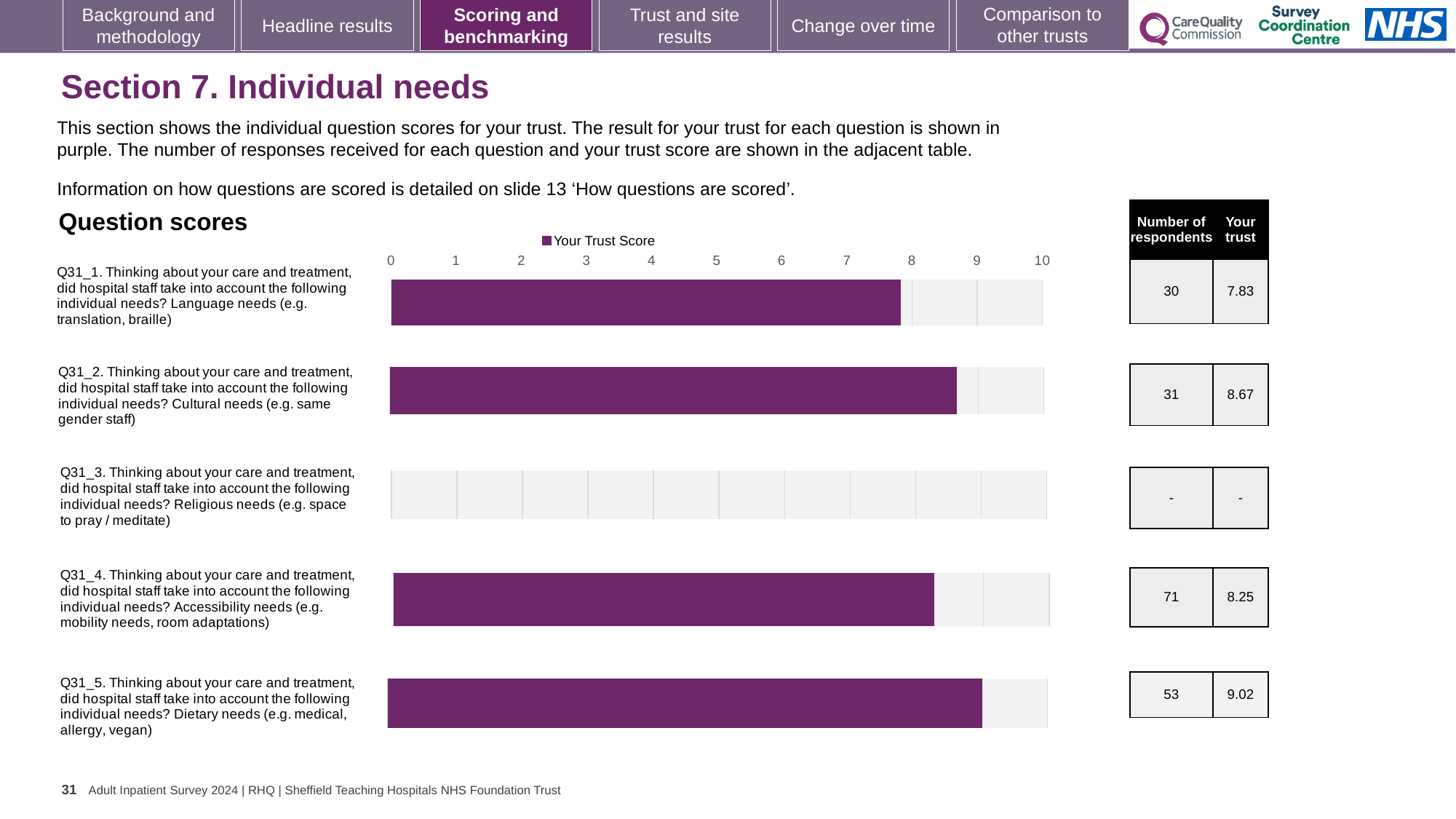
What is the trust score for Q31_5 (Dietary needs)? 9.02 What is the trust score for Q31_1 (Language needs)? 7.83 How many questions are listed in the chart? 5 Which question has the highest trust score? Q31_5 (Dietary needs) What is the trust score for Q31_4 (Accessibility needs)? 8.25 What kind of chart is shown on the slide? Bar chart Which has a higher trust score, Q31_2 (Cultural needs) or Q31_4 (Accessibility needs)? Q31_2 (Cultural needs) How many series does the legend list? 1 What is the name of the series shown in the legend? Your Trust Score What is the difference between the trust scores for Q31_5 (Dietary needs) and Q31_1 (Language needs)? 1.19 Is the trust score for Q31_2 (Cultural needs) greater or less than 8? greater Among the questions with a plotted score, which has the lowest trust score? Q31_1 (Language needs)